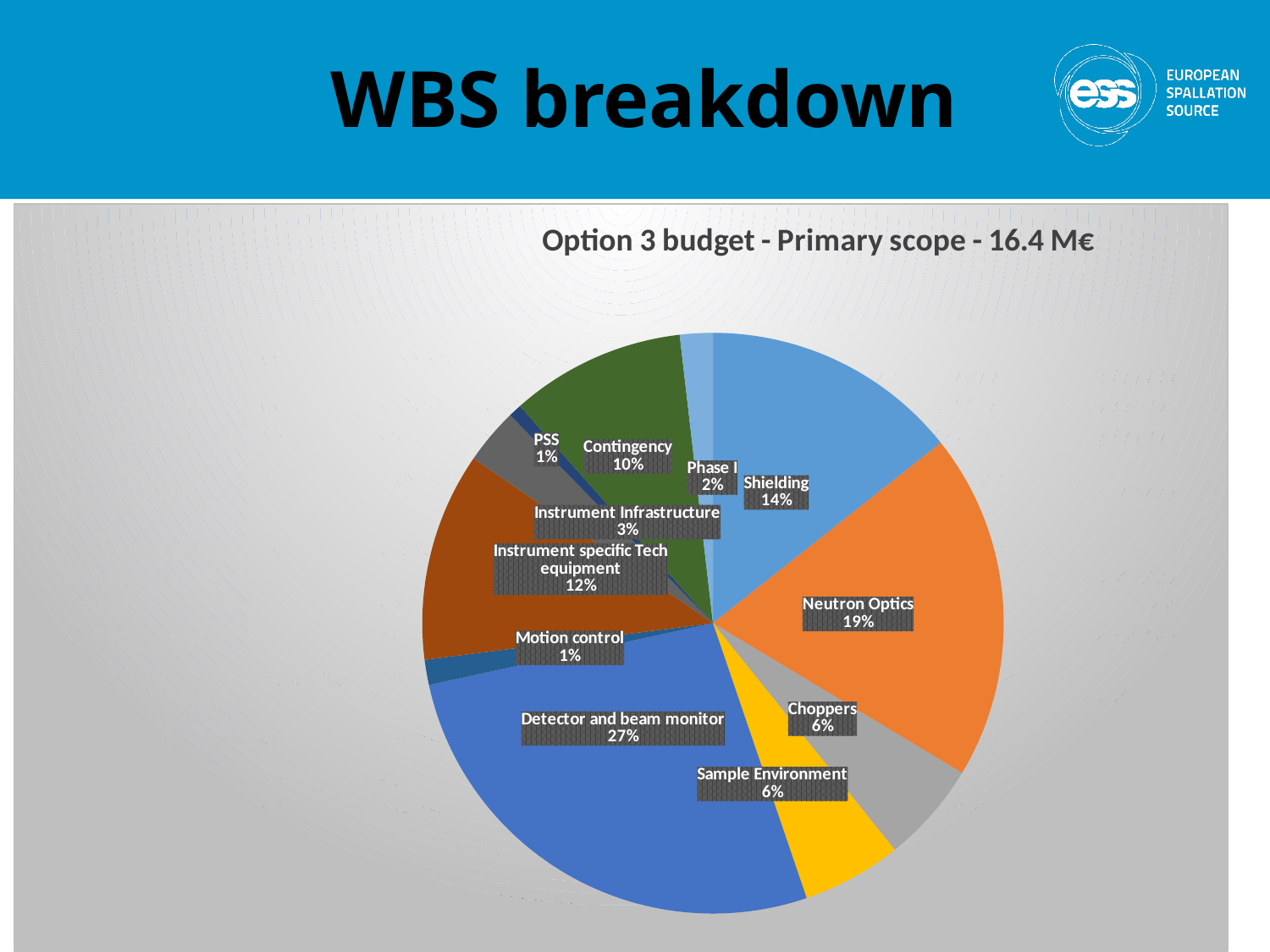
What percentage is shown for Instrument specific Tech equipment? 12% Which category has the largest slice of the pie? Detector and beam monitor What share of the budget does Detector and beam monitor take? 27% What percentage is shown for Contingency? 10% What share of the budget does Neutron Optics take? 19% How many slices does the pie chart have? 11 What is the difference in percentage points between Neutron Optics and Shielding? 5 What percentage is shown for Shielding? 14% What is the title of the pie chart? Option 3 budget - Primary scope - 16.4 M€ Which is larger, the share for Contingency or the share for Instrument Infrastructure? Contingency What kind of chart is shown on the slide? pie chart What percentage is shown for Phase I? 2%